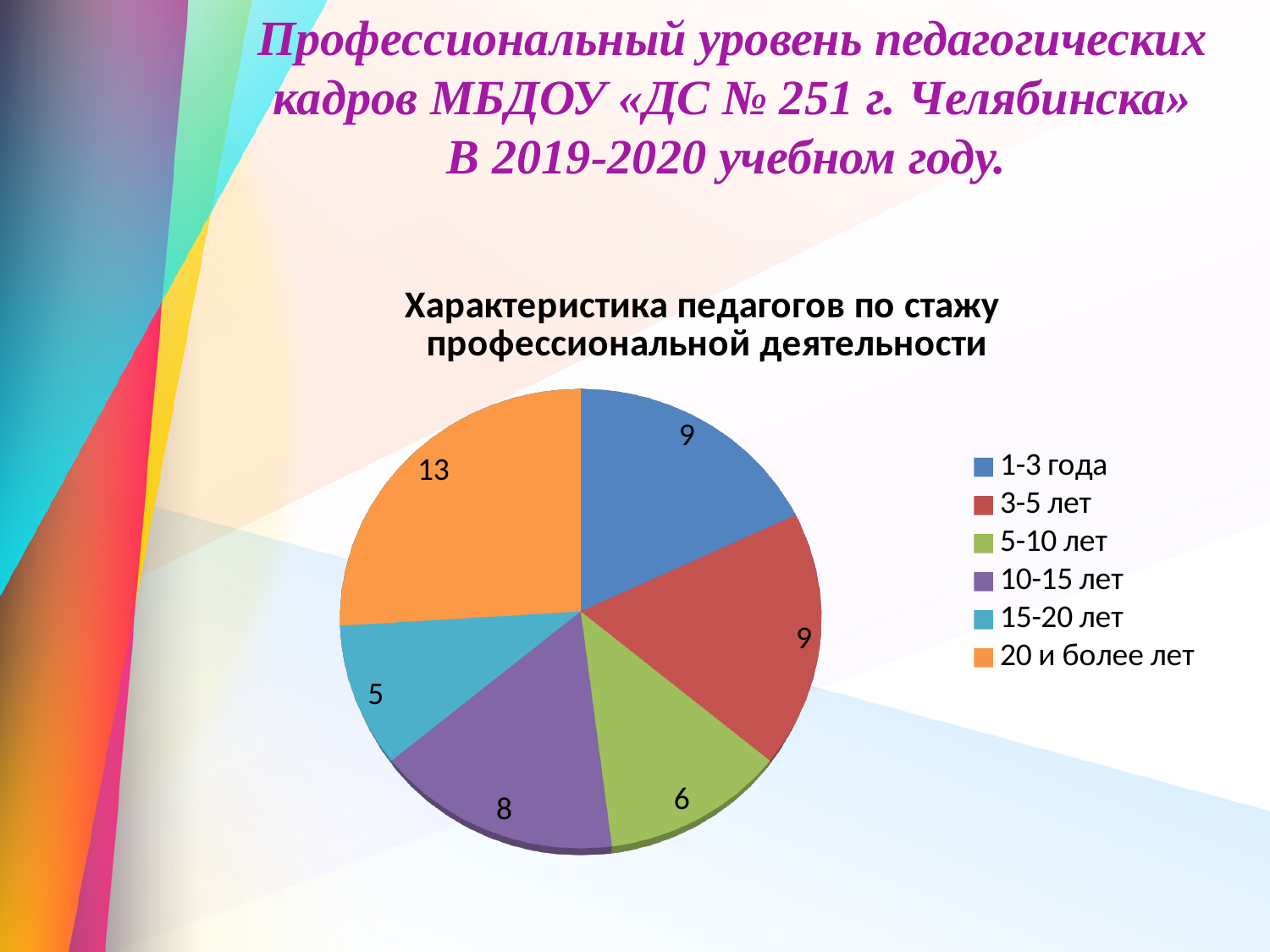
What type of chart is shown on the slide? pie chart Which category has the largest slice of the pie? 20 и более лет What is the difference between the values for "20 и более лет" and "15-20 лет"? 8 What is the value for the "15-20 лет" slice? 5 Which category has the smallest slice of the pie? 15-20 лет How many categories does the legend list? 6 What is the title of the chart? Характеристика педагогов по стажу профессиональной деятельности What is the value for the "10-15 лет" slice? 8 What is the value for the "5-10 лет" slice? 6 What share of the pie does the "20 и более лет" slice represent? 26% Which is larger, the value for "10-15 лет" or the value for "5-10 лет"? 10-15 лет What is the value for the "20 и более лет" slice? 13